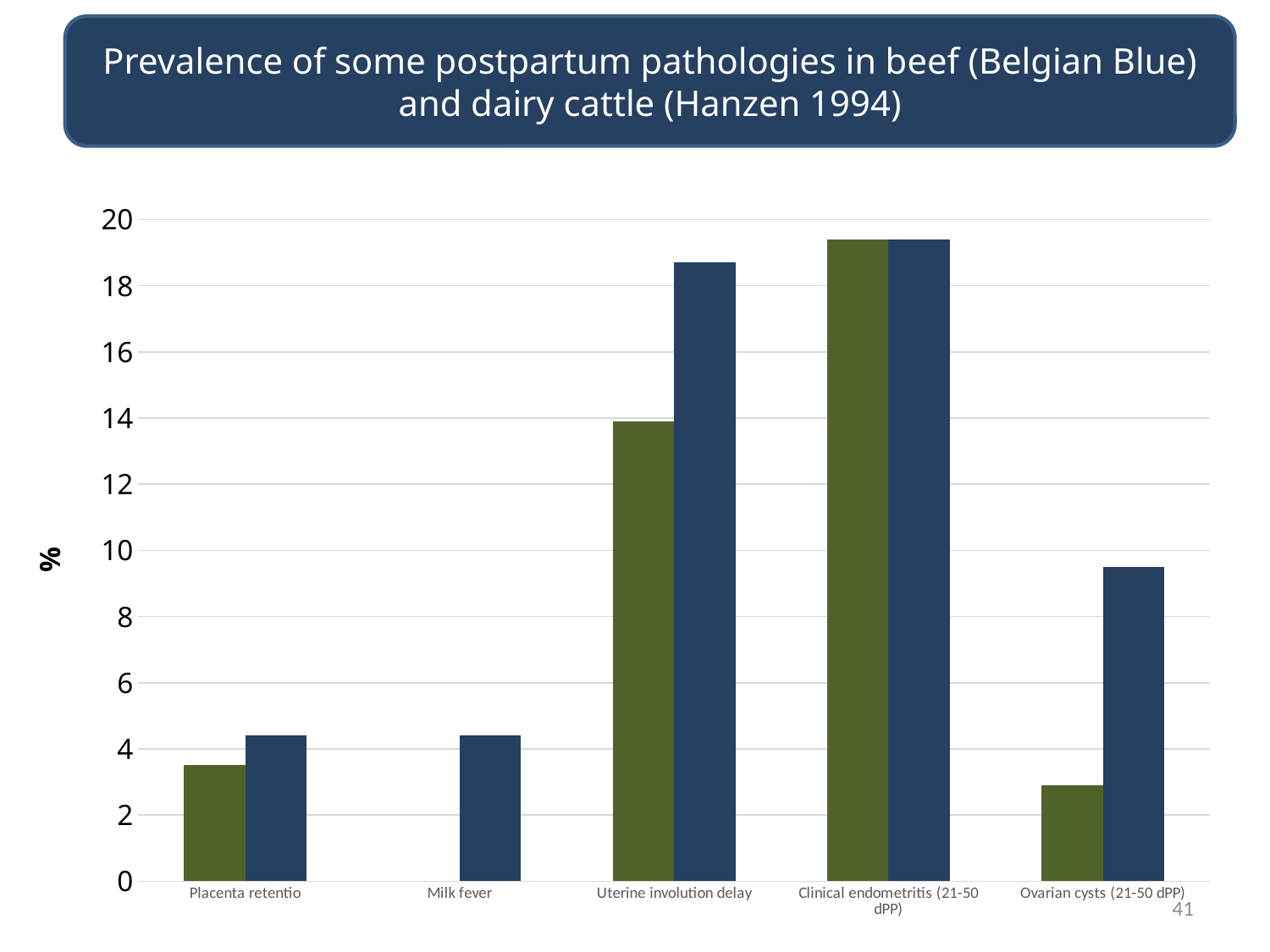
For Uterine involution delay, which bar is taller, the green bar or the dark blue bar? the dark blue bar What kind of chart is shown on the slide? bar chart Is the value of the green bar for Placenta retentio greater or less than 4? less Is the value of the dark blue bar for Ovarian cysts (21-50 dPP) greater or less than 10? less Which category has the highest dark blue bar? Clinical endometritis (21-50 dPP) Is the value of the dark blue bar for Uterine involution delay greater or less than 18? greater Among the categories that have a green bar, which has the lowest green bar? Ovarian cysts (21-50 dPP) Which is larger, the dark blue bar for Ovarian cysts (21-50 dPP) or the dark blue bar for Placenta retentio? Ovarian cysts (21-50 dPP) How many pathology categories are shown on the x axis? 5 What is the label on the y axis? %